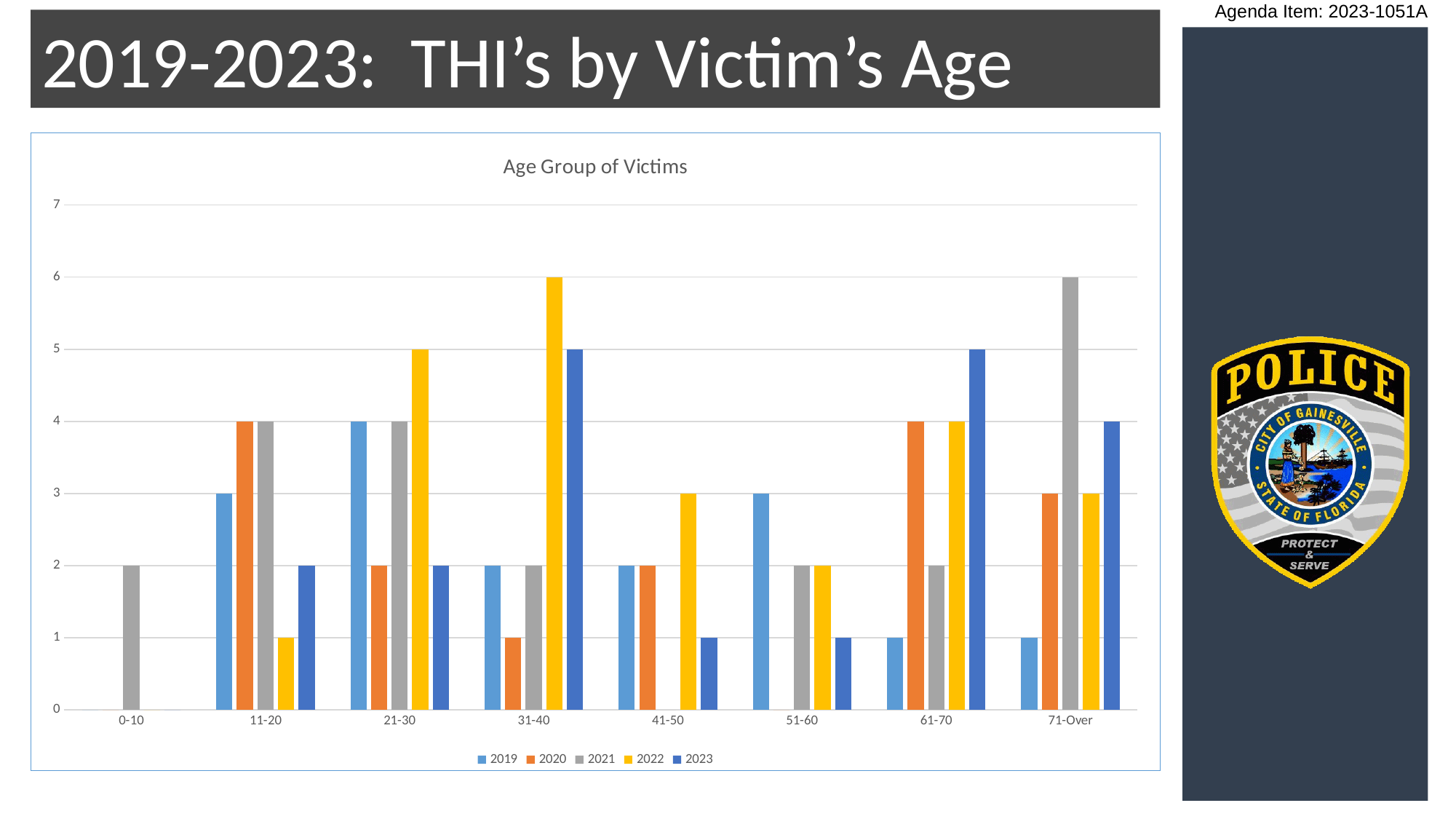
What is the value for 2023 in the 61-70 age group? 5 What is the title of the chart? Age Group of Victims What is the value for 2022 in the 31-40 age group? 6 What is the difference between the 2022 and 2020 values in the 31-40 age group? 5 Is the value for 2023 in the 31-40 age group greater or less than 4? greater Which age group has the highest value for the 2022 series? 31-40 Which age group has the highest value for the 2021 series? 71-Over How many series does the legend list? 5 How many age group categories are shown on the x axis? 8 What kind of chart is shown on the slide? bar chart What is the value for 2021 in the 71-Over age group? 6 In the 21-30 age group, which is larger, the 2022 value or the 2020 value? 2022